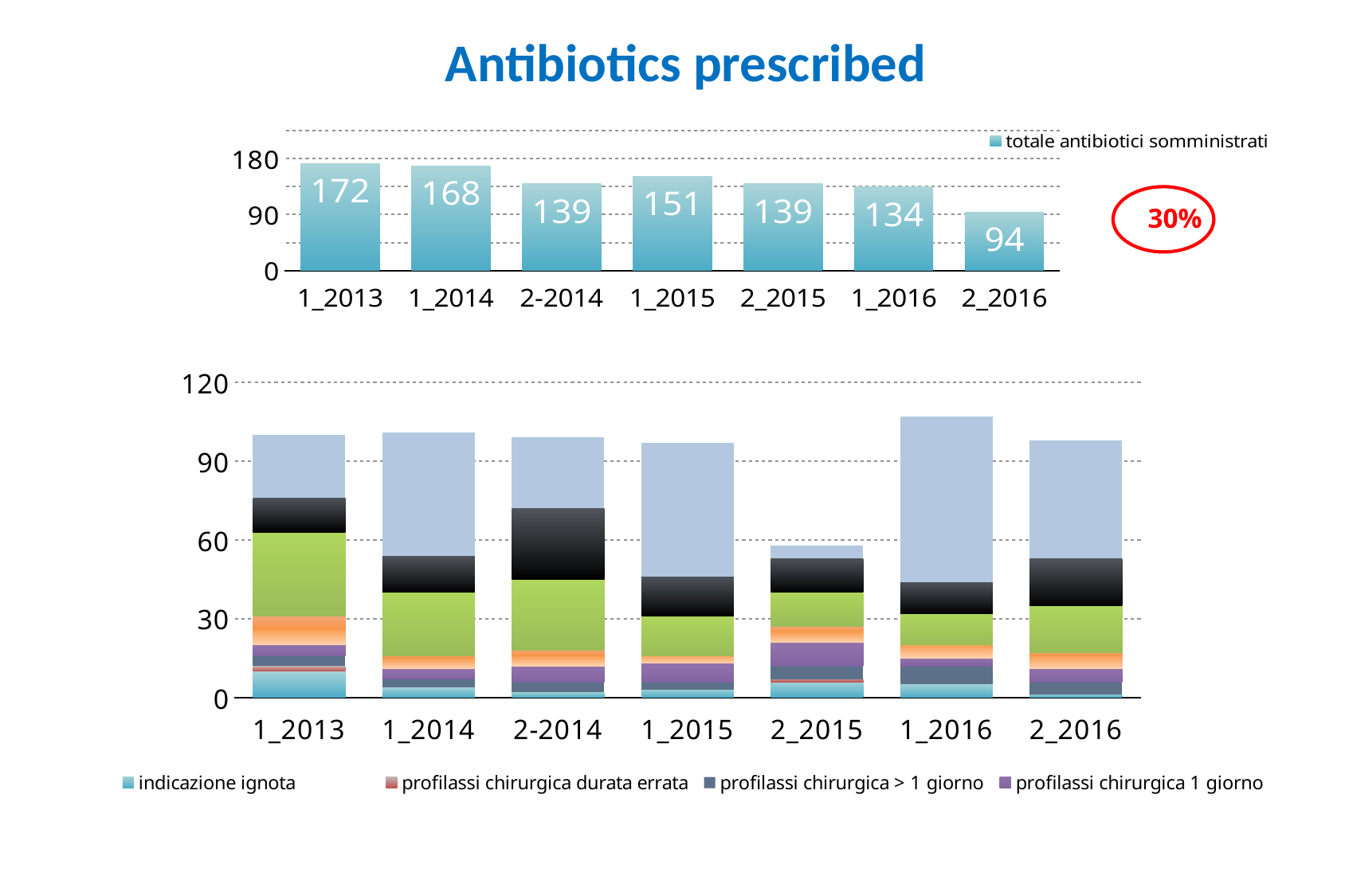
In the top chart, what is the value for 2_2016? 94 In the top chart, do the values generally rise or fall from 1_2013 to 2_2016? fall How many periods are shown on the x axis of the top chart? 7 In the top chart, which is larger, the value for 1_2015 or the value for 1_2016? 1_2015 In the top chart, which period has the lowest value? 2_2016 What is the legend entry of the top chart? totale antibiotici somministrati In the top chart, which period has the highest value? 1_2013 In the bottom stacked bar chart, which period has the lowest total bar height? 2_2015 In the top chart (totale antibiotici somministrati), what is the value for 1_2013? 172 In the top chart, what is the difference between the values for 1_2013 and 2_2016? 78 What kind of chart is the top chart? bar chart